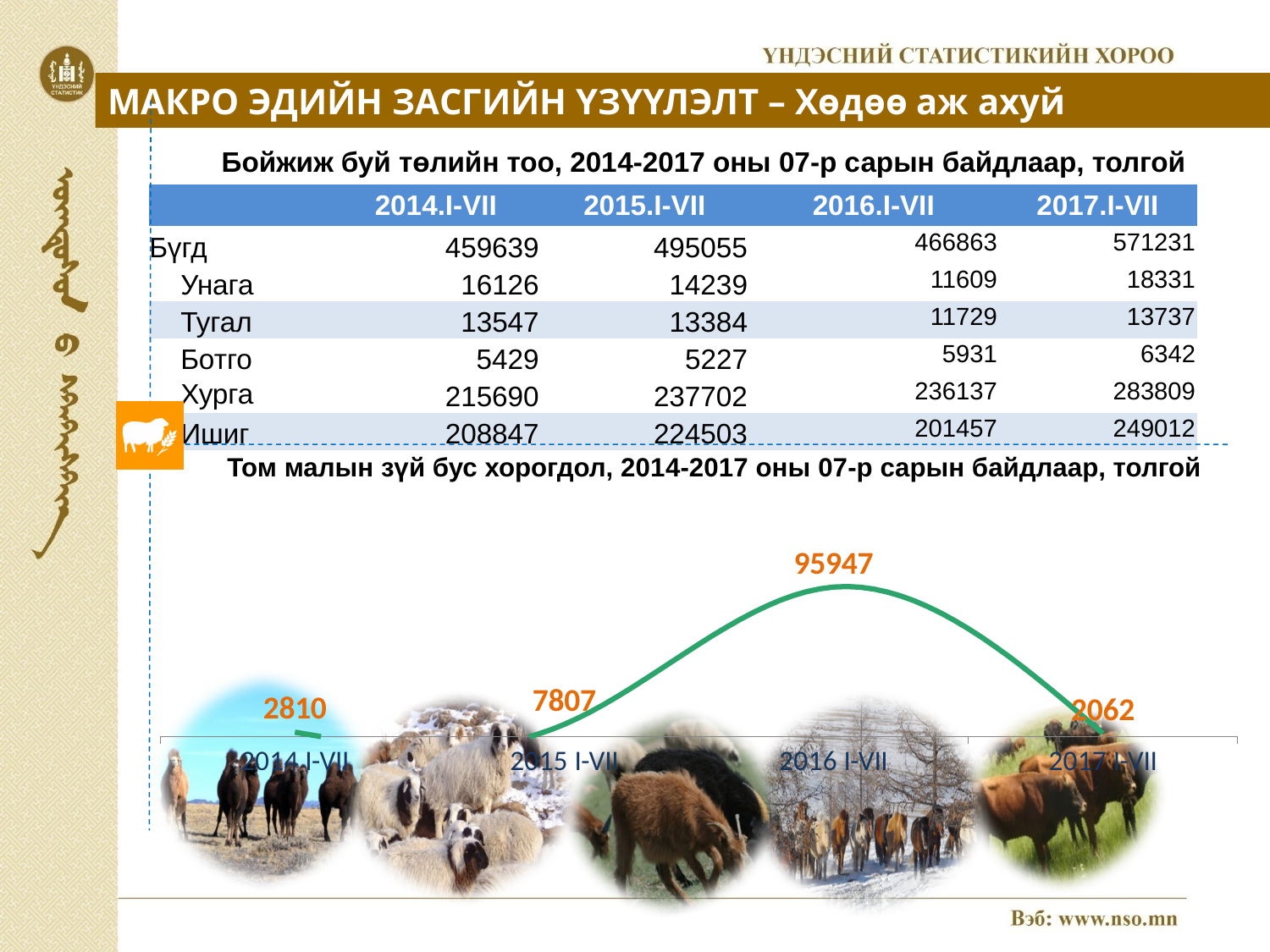
In the line chart at the bottom of the slide, which period has the lowest value? 2017 I-VII In the line chart at the bottom of the slide, what is the value for 2014 I-VII? 2810 In the line chart at the bottom of the slide, what is the difference between the values for 2015 I-VII and 2014 I-VII? 4997 In the line chart at the bottom of the slide, what is the value for 2015 I-VII? 7807 In the line chart at the bottom of the slide, which is larger, the value for 2014 I-VII or the value for 2017 I-VII? 2014 I-VII How many periods are plotted in the line chart at the bottom of the slide? 4 In the line chart at the bottom of the slide, which period has the highest value? 2016 I-VII What kind of chart is shown at the bottom of the slide? line chart In the line chart at the bottom of the slide, what is the value for 2016 I-VII? 95947 In the line chart at the bottom of the slide, what is the difference between the values for 2016 I-VII and 2015 I-VII? 88140 In the line chart at the bottom of the slide, does the value rise or fall from 2016 I-VII to 2017 I-VII? fall In the line chart at the bottom of the slide, what is the value for 2017 I-VII? 2062